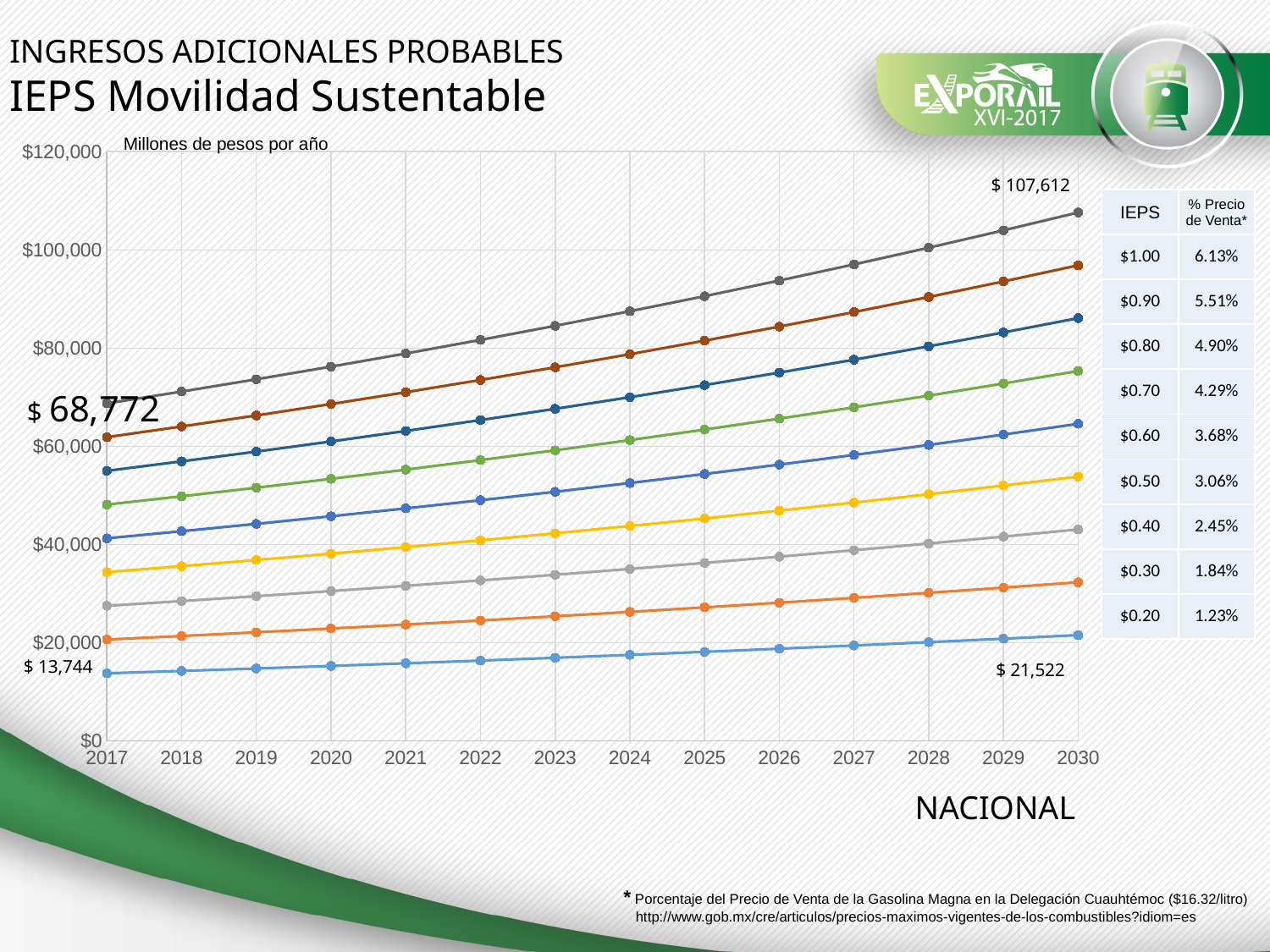
How many lines (series) are plotted on the chart? 9 By how much does the highest line increase from 2017 to 2030? 38,840 How many years are shown along the x axis of the chart? 14 What is the labelled value of the highest line in 2030? $ 107,612 Do the values of the lines rise or fall from 2017 to 2030? rise What is the labelled value of the lowest line in 2017? $ 13,744 What is the labelled value of the lowest line in 2030? $ 21,522 What is the labelled value of the highest line in 2017? $ 68,772 By how much does the lowest line increase from 2017 to 2030? 7,778 Is the value of the highest line in 2025 greater or less than $80,000? greater What kind of chart is shown on the slide? line chart What is the difference between the highest and lowest lines in 2030? 86,090